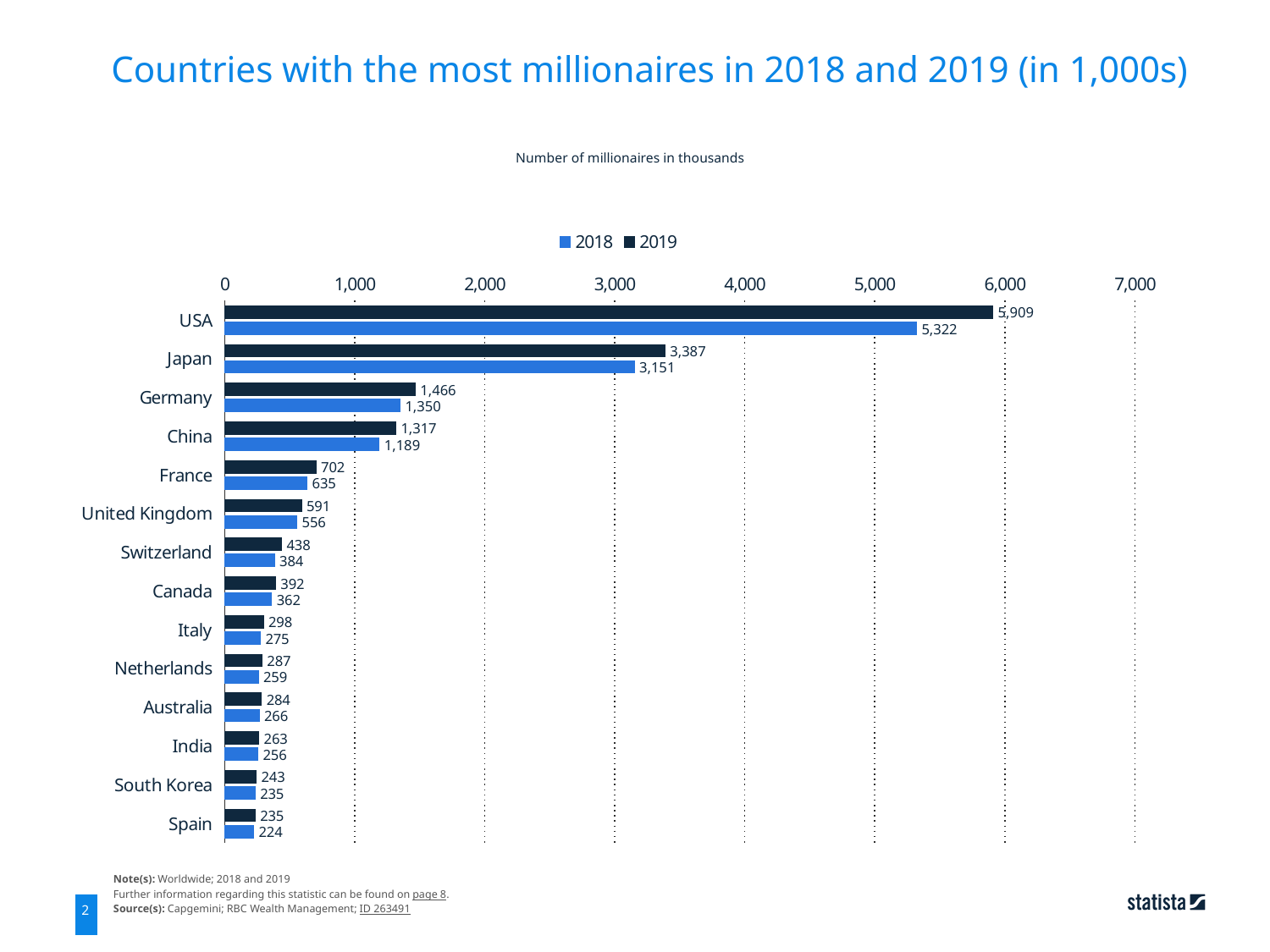
Which is larger, the 2019 value for France or the 2019 value for the United Kingdom? France Is the 2018 value for China greater or less than 1,000? greater What is the 2018 value for Japan? 3,151 What is the difference between the 2019 values for Japan and China? 2,070 What is the 2018 value for Switzerland? 384 How many countries are shown in the chart? 14 What kind of chart is shown on the slide? Bar chart Which country has the highest 2019 value? USA What is the 2019 value for the USA? 5,909 Which country has the lowest 2018 value? Spain What is the difference between the 2019 and 2018 values for Germany? 116 How many series does the legend list? 2